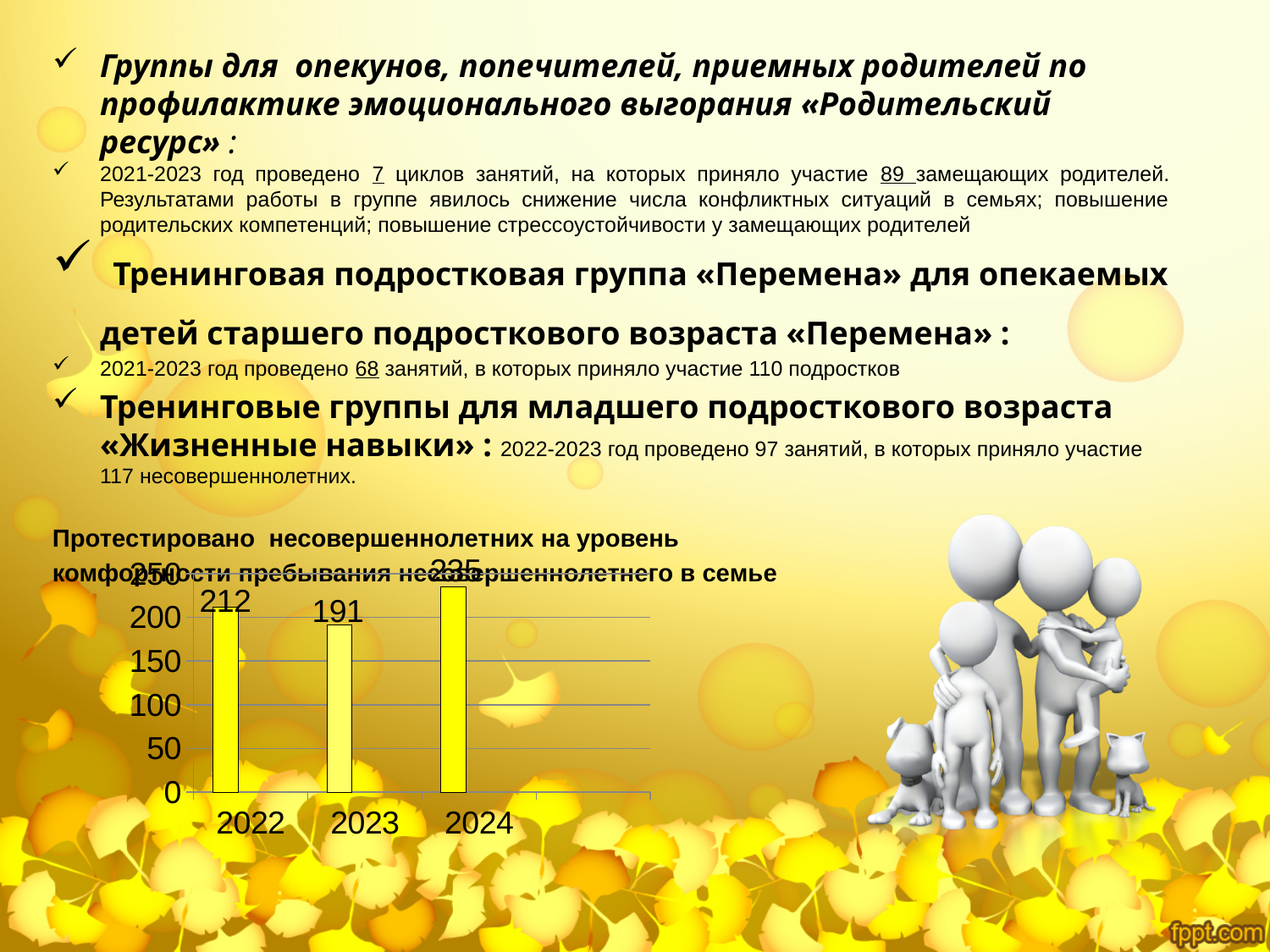
Which year has the highest value in the bar chart? 2024 What colour are the bars in the chart? yellow What is the difference between the values for 2022 and 2023? 21 What kind of chart is shown on the slide? bar chart What is the value for 2023 in the bar chart? 191 Which year has the lowest value in the bar chart? 2023 Is the value for 2023 greater or less than 200? less Is the value for 2024 greater or less than 200? greater How many years are shown on the x axis of the chart? 3 Which is larger, the value for 2022 or the value for 2023? 2022 What is the value for 2022 in the bar chart? 212 Does the value fall or rise from 2022 to 2023? fall